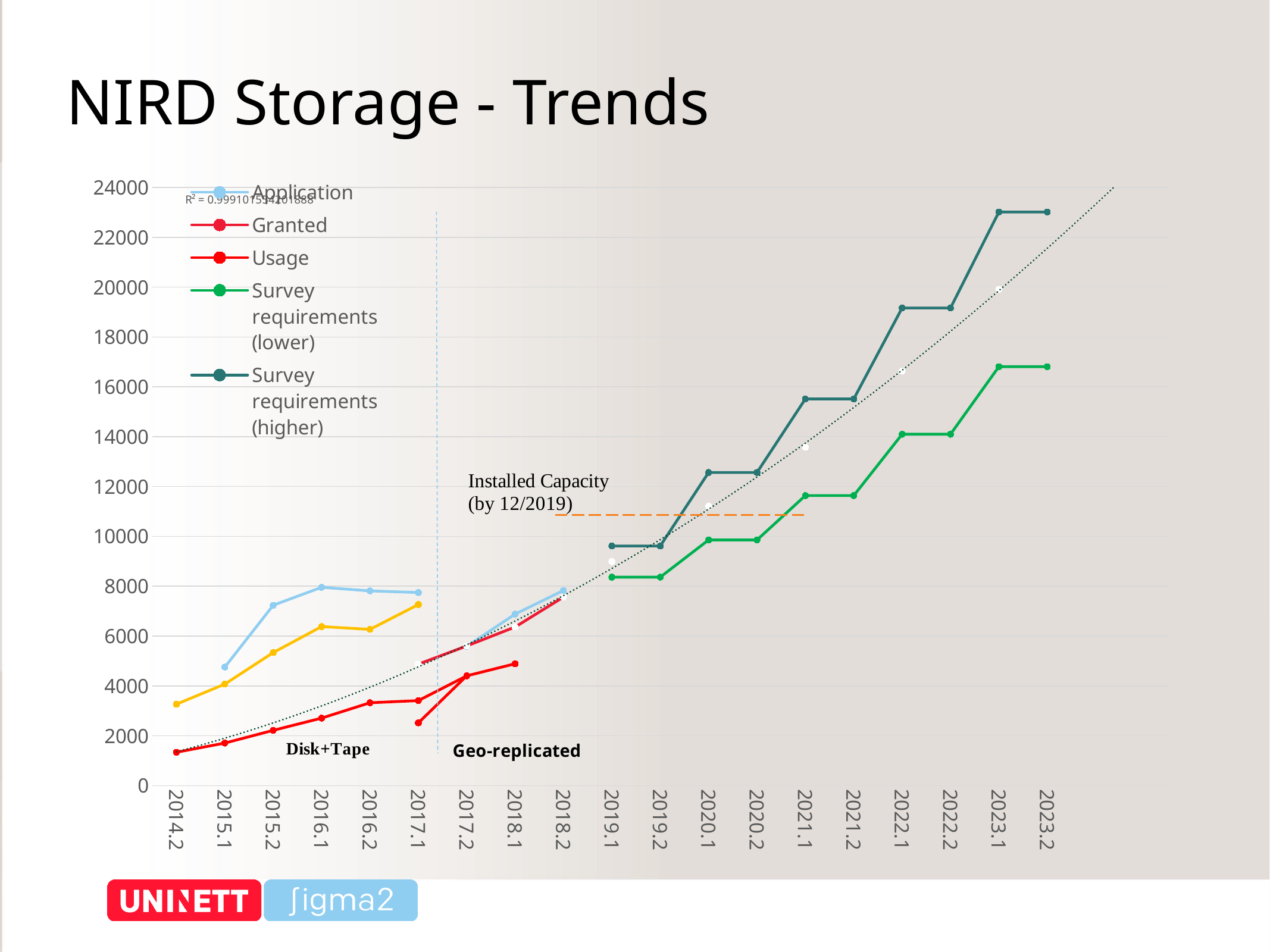
Do the values for Survey requirements (lower) rise or fall from 2019.1 to 2023.2? rise Is the value for Usage at 2014.2 greater or less than 2000? less At 2023.2, which is larger: Survey requirements (higher) or Survey requirements (lower)? Survey requirements (higher) What kind of chart is shown on the slide? line chart Is the value for Usage at 2018.1 greater or less than 6000? less Is the value for Survey requirements (lower) at 2023.2 greater or less than 18000? less Which series reaches the highest value on the chart? Survey requirements (higher) What does the dashed orange horizontal line on the chart represent? Installed Capacity (by 12/2019) How many series does the legend list? 5 How many categories are shown on the x axis? 19